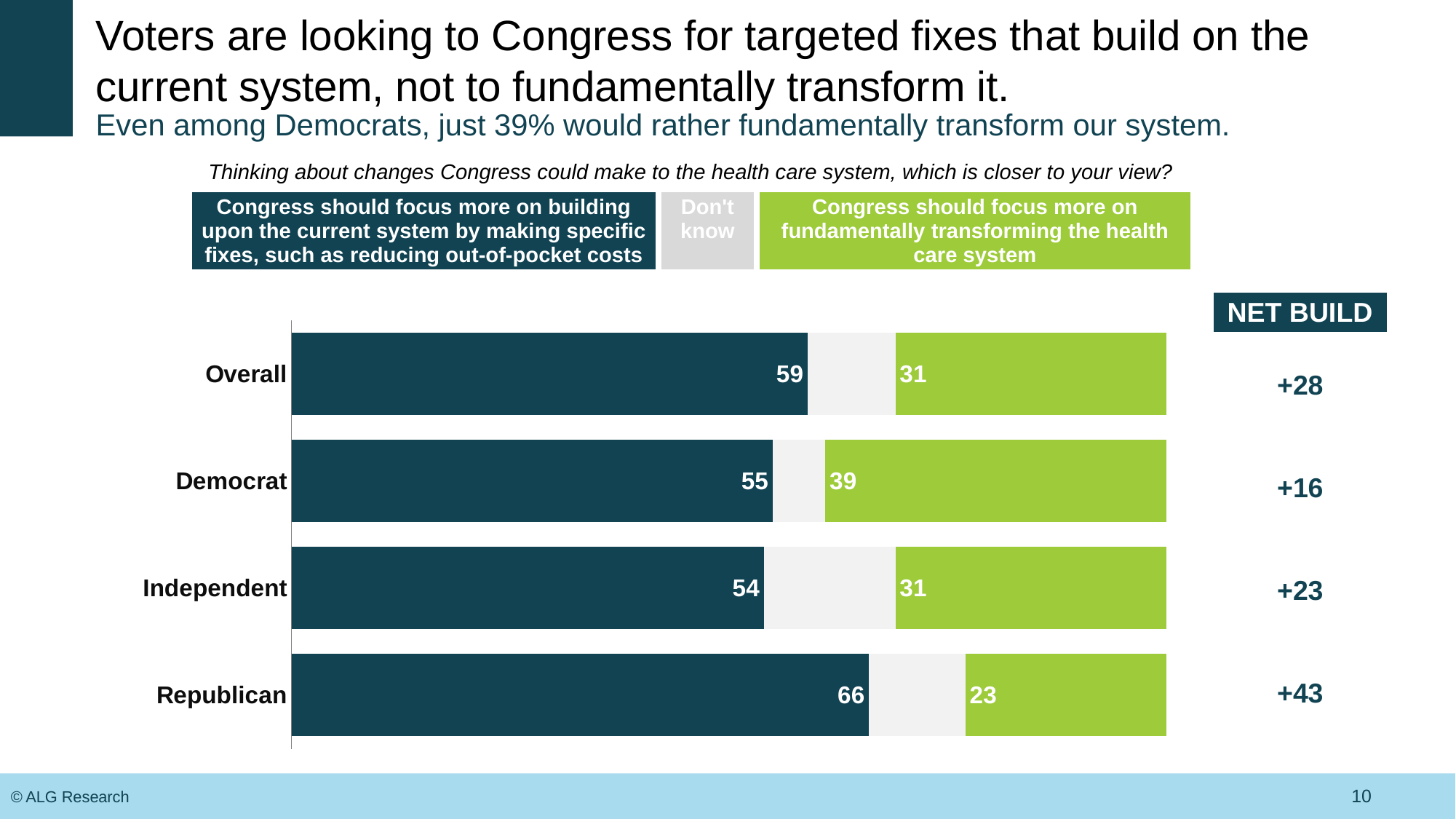
Which is larger: the percentage of Independents who favor building on the current system or the percentage who favor fundamentally transforming it? Building on the current system How many groups are shown in the chart? 4 Which group has the highest percentage saying Congress should focus on building upon the current system? Republican What is the NET BUILD value for Independents? +23 Which group has the lowest percentage saying Congress should focus on fundamentally transforming the health care system? Republican What percentage of Republicans say Congress should focus more on building upon the current system? 66 How many response options does the legend list? 3 What type of chart is shown on the slide? Stacked bar chart What percentage of Overall respondents say Congress should focus more on building upon the current system? 59 What is the difference between the percentage of Republicans and Democrats who say Congress should focus on building upon the current system? 11 Which group has the highest NET BUILD value? Republican What percentage of Democrats say Congress should focus more on fundamentally transforming the health care system? 39